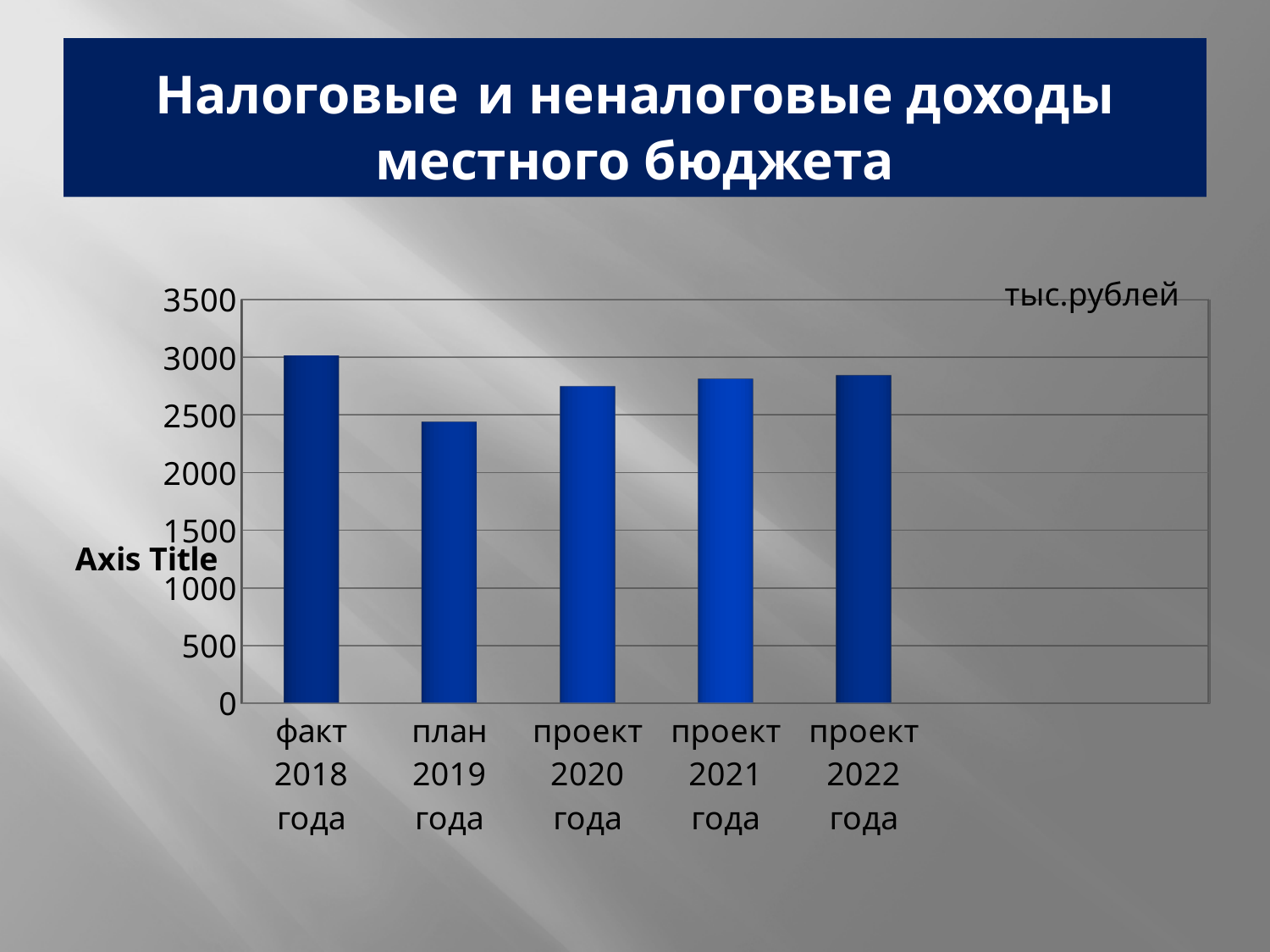
Which is larger: the value for факт 2018 года or the value for план 2019 года? факт 2018 года Is the value for факт 2018 года greater or less than 2500? greater Is the value for проект 2022 года greater or less than 3000? less Which is larger: the value for план 2019 года or the value for проект 2020 года? проект 2020 года What kind of chart is shown on the slide? bar chart Which category has the highest value? факт 2018 года Which category has the lowest value? план 2019 года How many bars (categories) does the chart show? 5 What unit is indicated in the top right corner of the chart? тыс.рублей What is the title of the slide above the chart? Налоговые и неналоговые доходы местного бюджета Is the value for план 2019 года greater or less than 2500? less